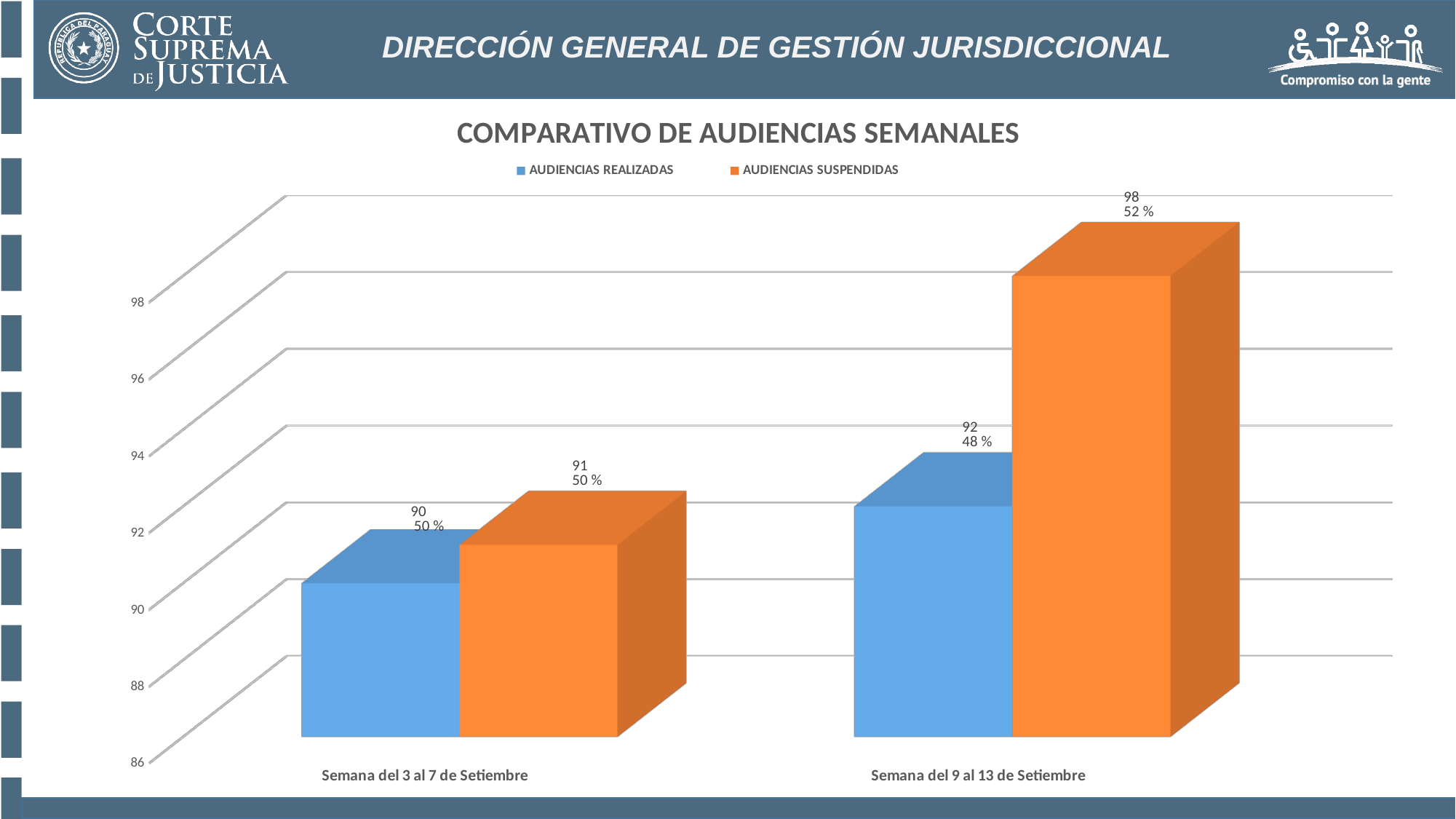
What is the value of AUDIENCIAS SUSPENDIDAS for Semana del 3 al 7 de Setiembre? 91 How many series does the legend list? 2 What is the value of AUDIENCIAS REALIZADAS for Semana del 3 al 7 de Setiembre? 90 Which bar has the highest value in the chart? AUDIENCIAS SUSPENDIDAS, Semana del 9 al 13 de Setiembre What is the title of the chart? COMPARATIVO DE AUDIENCIAS SEMANALES What is the difference between AUDIENCIAS SUSPENDIDAS and AUDIENCIAS REALIZADAS for Semana del 9 al 13 de Setiembre? 6 Which bar has the lowest value in the chart? AUDIENCIAS REALIZADAS, Semana del 3 al 7 de Setiembre What percentage is shown for AUDIENCIAS REALIZADAS in Semana del 9 al 13 de Setiembre? 48 % What kind of chart is shown on the slide? Bar chart How many weeks (categories) are shown on the x axis? 2 Which is larger for Semana del 9 al 13 de Setiembre: AUDIENCIAS REALIZADAS or AUDIENCIAS SUSPENDIDAS? AUDIENCIAS SUSPENDIDAS What is the value of AUDIENCIAS SUSPENDIDAS for Semana del 9 al 13 de Setiembre? 98